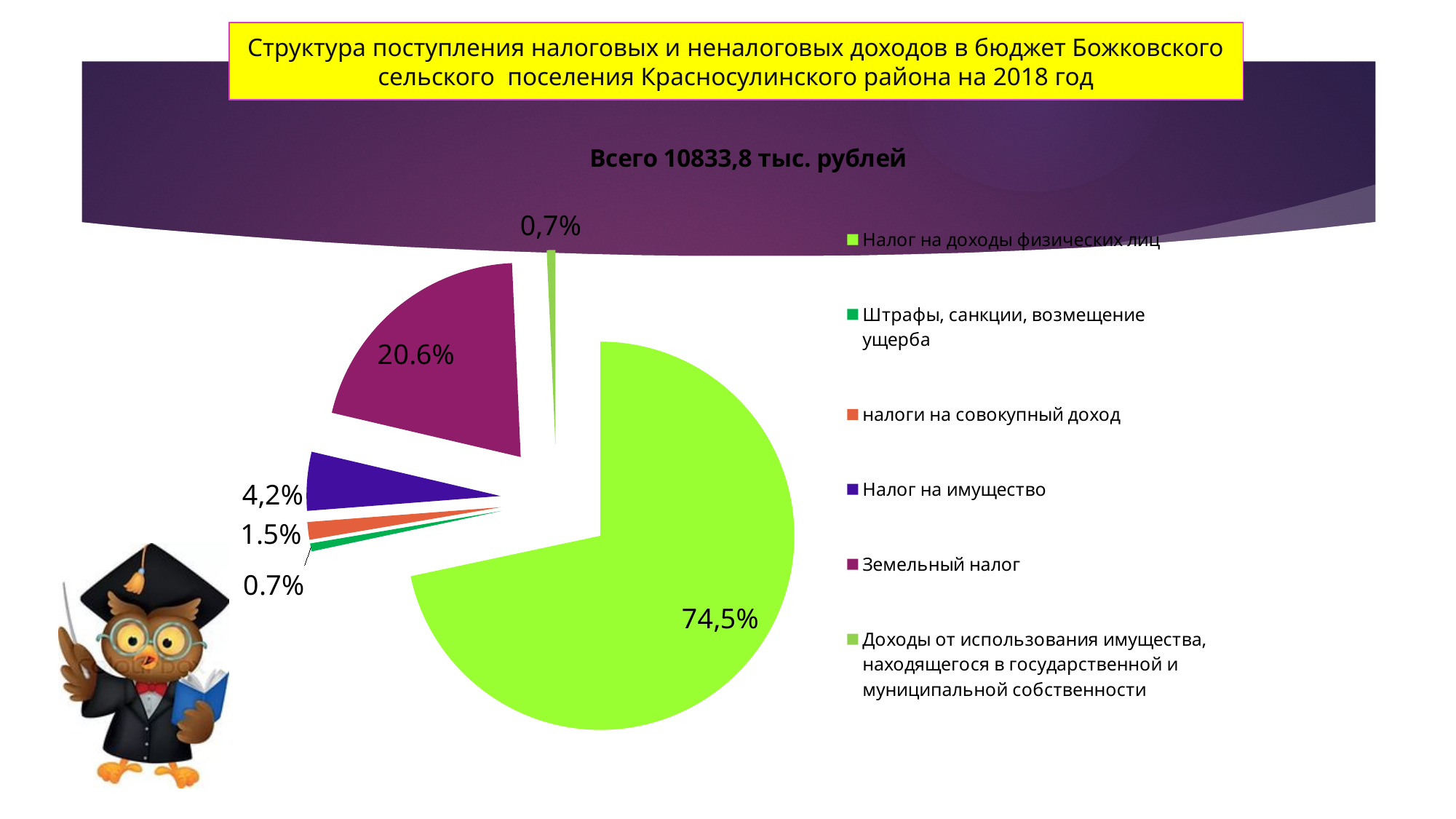
What share of the pie does Налог на доходы физических лиц account for? 74,5% What is the value labelled for Налог на имущество? 4,2% What percentage is shown for налоги на совокупный доход? 1.5% How many slices does the pie chart have? 6 What total amount is stated in the chart title? 10833,8 тыс. рублей Which category has the largest slice of the pie? Налог на доходы физических лиц How many entries does the legend list? 6 What type of chart is shown on the slide? pie chart By how many percentage points does Земельный налог exceed Налог на имущество? 16.4% What percentage is shown for Земельный налог? 20.6% Which is larger: the slice for Земельный налог or the slice for Налог на имущество? Земельный налог What share does Штрафы, санкции, возмещение ущерба have in the pie? 0.7%